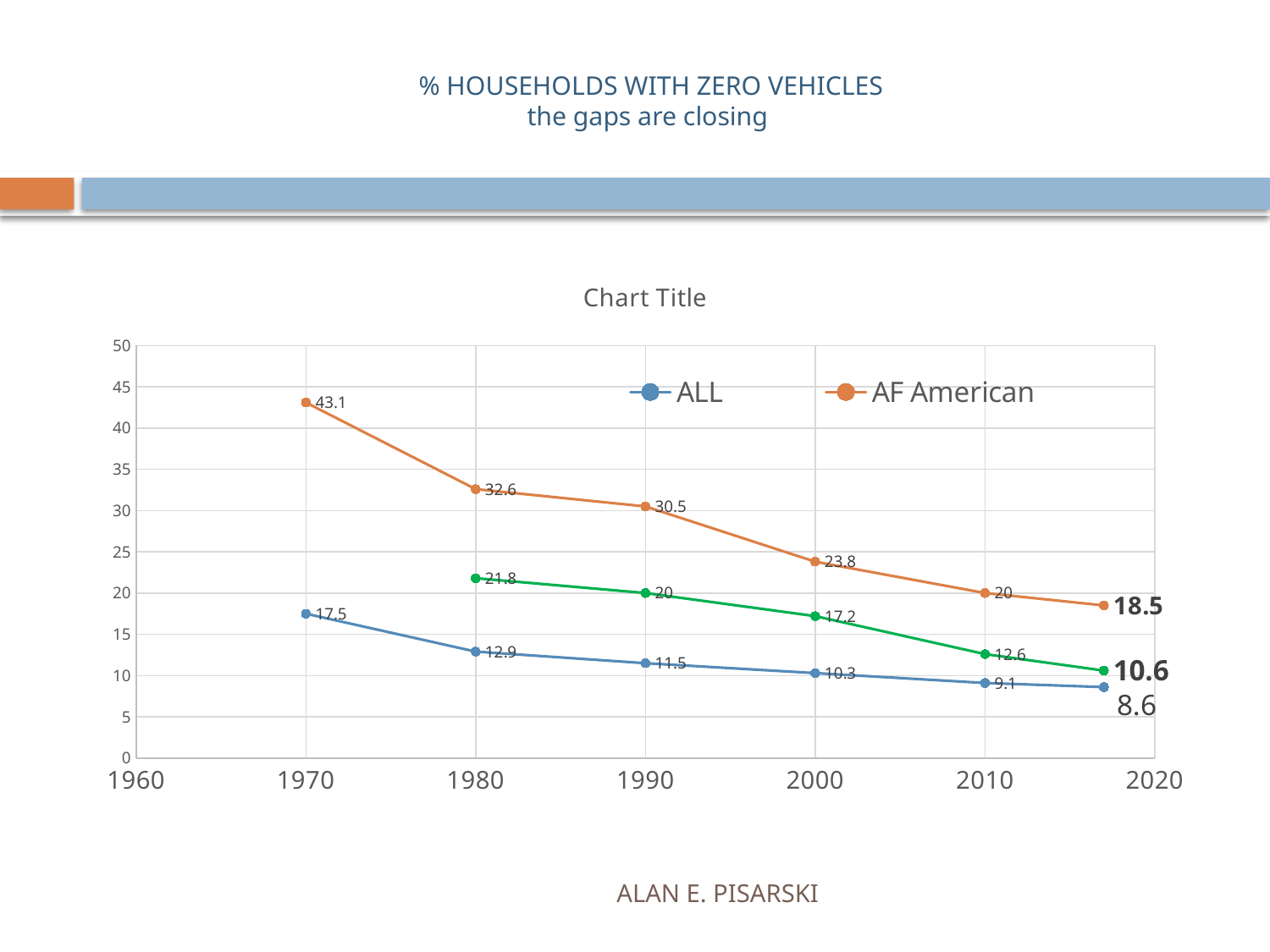
What is the lowest value shown for the ALL series? 8.6 Does the AF American series rise or fall from 1970 to the final point? fall By how much did the AF American value fall from 1970 to 1980? 10.5 In which year is the AF American series at its highest? 1970 In 2010, which series has the larger value, ALL or AF American? AF American What kind of chart is shown on the slide? line chart What is the difference between the AF American and ALL values in 1970? 25.6 Is the value for AF American in 1990 greater or less than 30? greater How many series does the legend list? 2 What is the value for AF American in 1970? 43.1 What is the value for ALL in 2000? 10.3 What is the value for ALL in 1980? 12.9